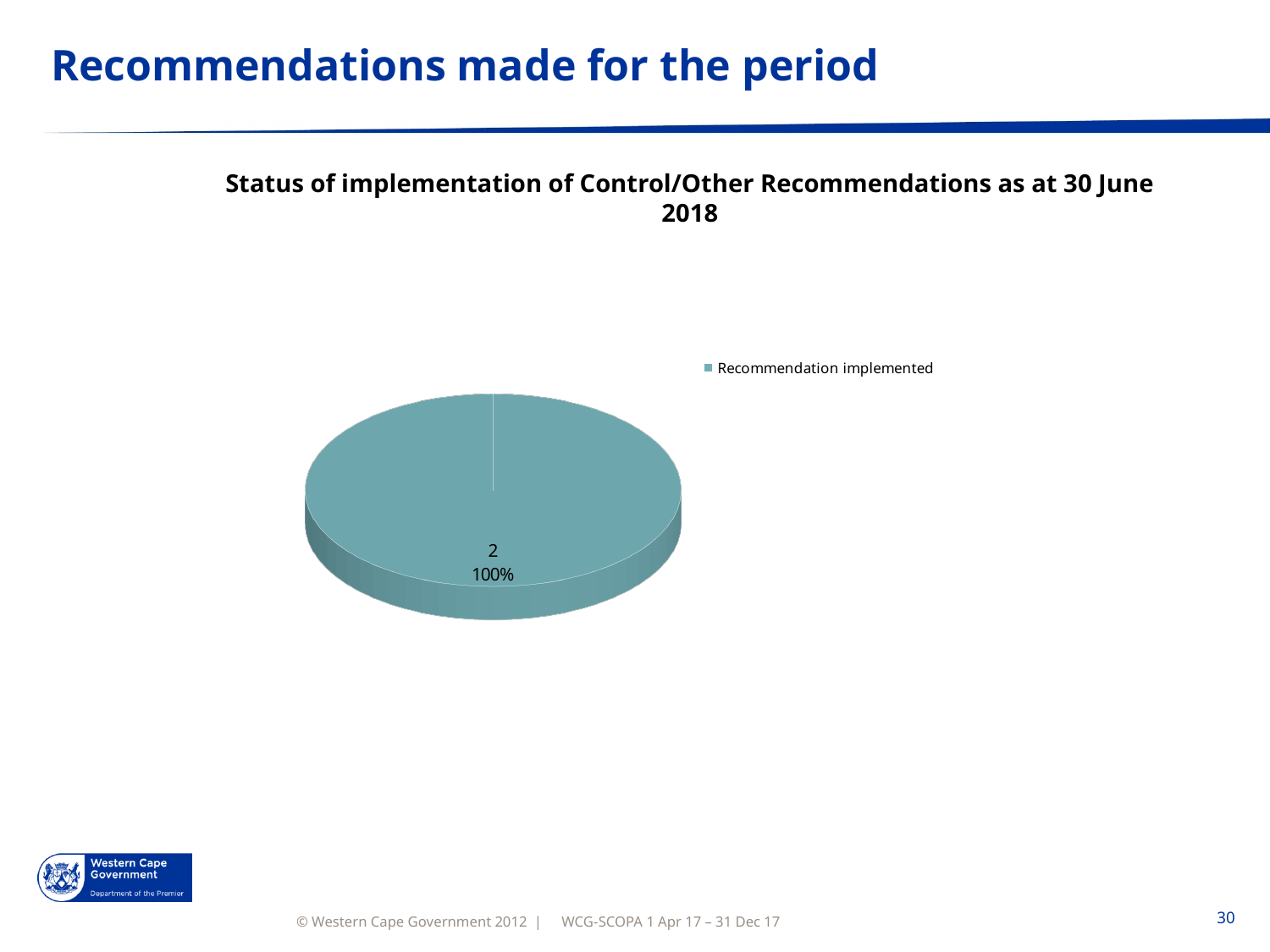
What is the value shown for Recommendation implemented? 2 What share of the pie does Recommendation implemented represent? 100% How many categories does the legend list? 1 Is the value for Recommendation implemented greater or less than 1? greater What is the only legend entry on the chart? Recommendation implemented What is the title of the chart? Status of implementation of Control/Other Recommendations as at 30 June 2018 What kind of chart is shown on the slide? pie chart How many slices does the pie chart have? 1